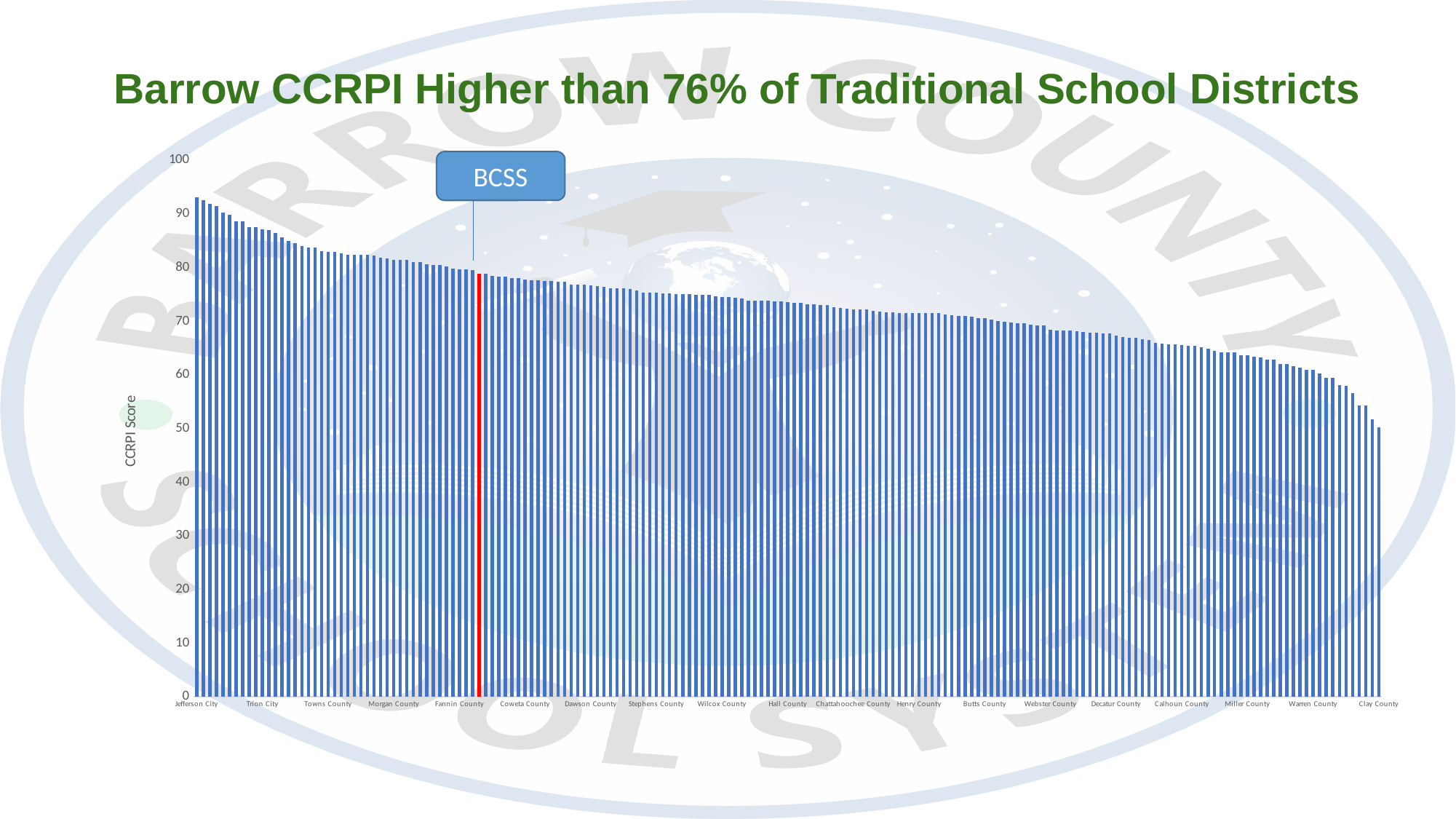
Is the CCRPI score for Coweta County greater or less than 80? less Which has the higher CCRPI score, Jefferson City or Clay County? Jefferson City Which district has the lowest CCRPI score in the chart? Clay County Which district's bar is highlighted in red and labelled with a callout? BCSS Is the CCRPI score for Jefferson City greater or less than 90? greater Which district has the highest CCRPI score in the chart? Jefferson City Is the CCRPI score for Trion City greater or less than 80? greater What kind of chart is shown on the slide? bar chart Do the CCRPI scores rise or fall moving from left to right along the x axis? fall